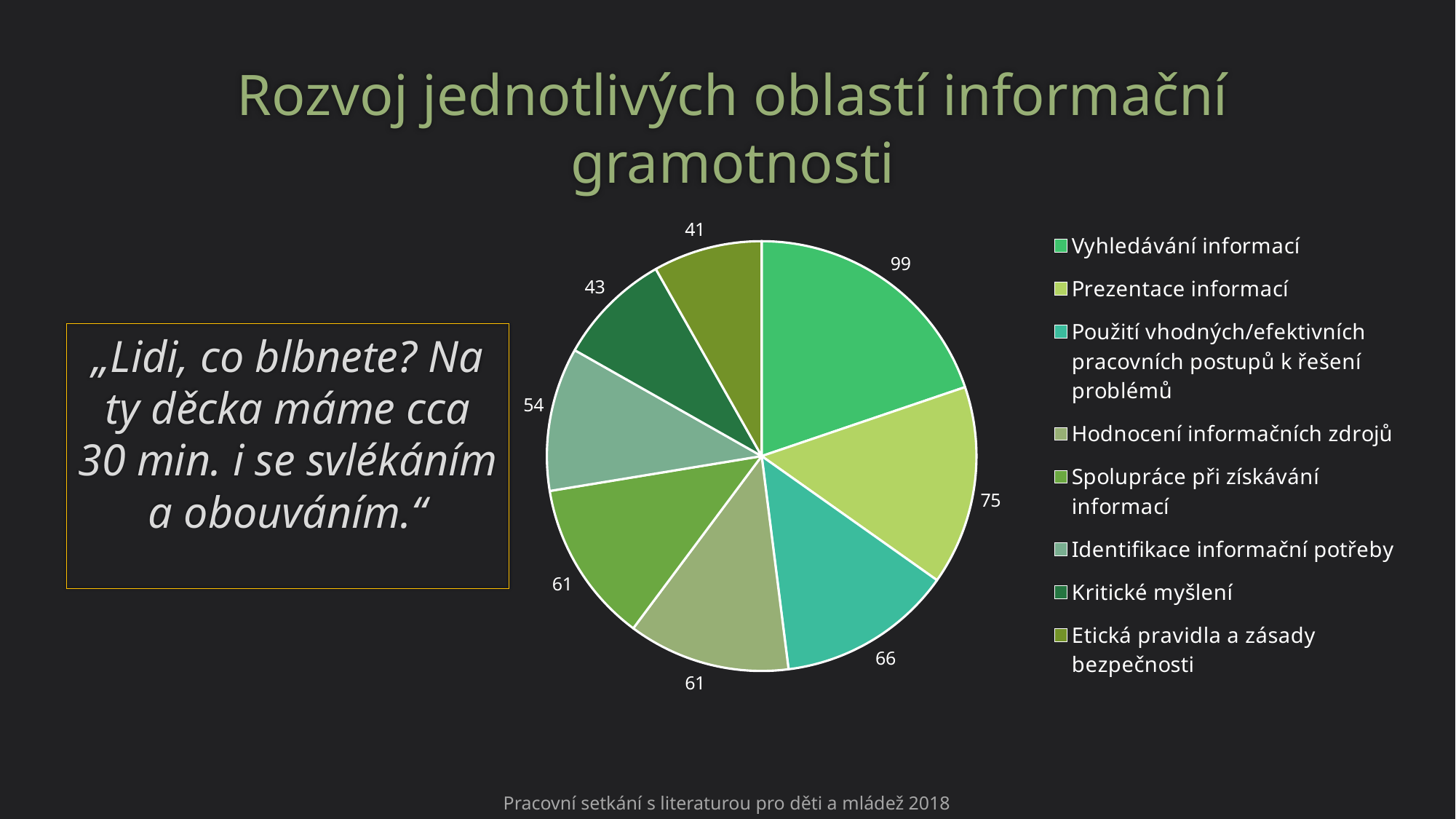
Which is larger, the value for Prezentace informací or the value for Identifikace informační potřeby? Prezentace informací What kind of chart is shown on the slide? pie chart Which category has the largest slice of the pie? Vyhledávání informací What share of the pie does Prezentace informací represent? 15% What value is shown for Vyhledávání informací? 99 What value is shown for Kritické myšlení? 43 What is the difference between the values for Vyhledávání informací and Prezentace informací? 24 Which category has the smallest slice of the pie? Etická pravidla a zásady bezpečnosti What value is shown for Identifikace informační potřeby? 54 How many slices does the pie chart have? 8 What is the total of all the values in the pie chart? 500 What is the title of the slide containing the chart? Rozvoj jednotlivých oblastí informační gramotnosti